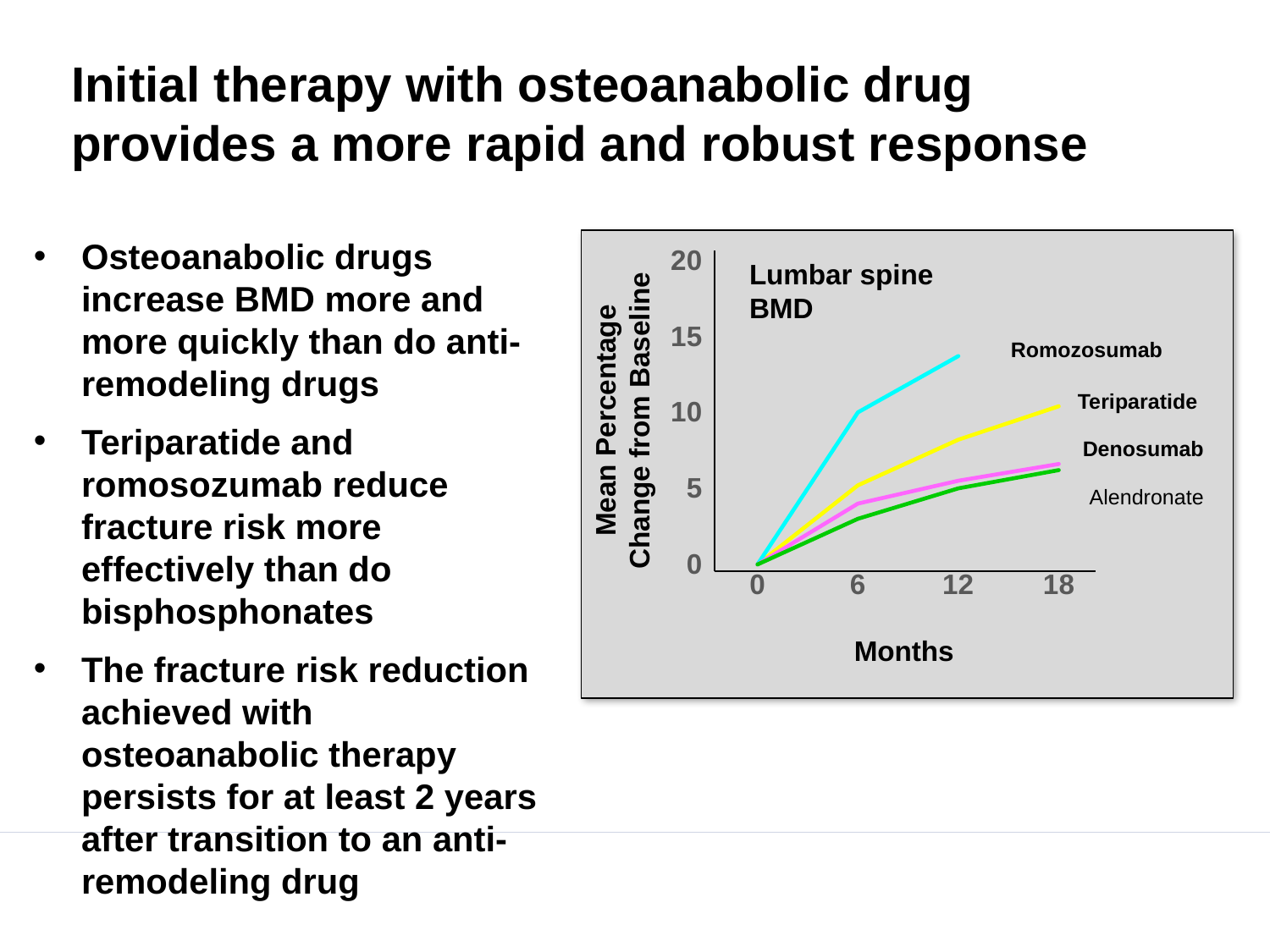
At 12 months, which is larger: the value for Romozosumab or the value for Teriparatide? Romozosumab Is the value for Alendronate at 18 months greater or less than 10? less Is the value for Romozosumab at 12 months greater or less than 10? greater What kind of chart is shown on the slide? line chart Which drug has the highest mean percentage change from baseline at 12 months? Romozosumab What is the title printed inside the chart area? Lumbar spine BMD Do the values for Teriparatide rise or fall as months increase? rise What is the label of the x axis? Months How many tick values are shown on the x axis? 4 Which drug has the lowest mean percentage change from baseline at 18 months? Alendronate How many drug series are plotted in the chart? 4 Is the value for Alendronate at 6 months greater or less than 5? less